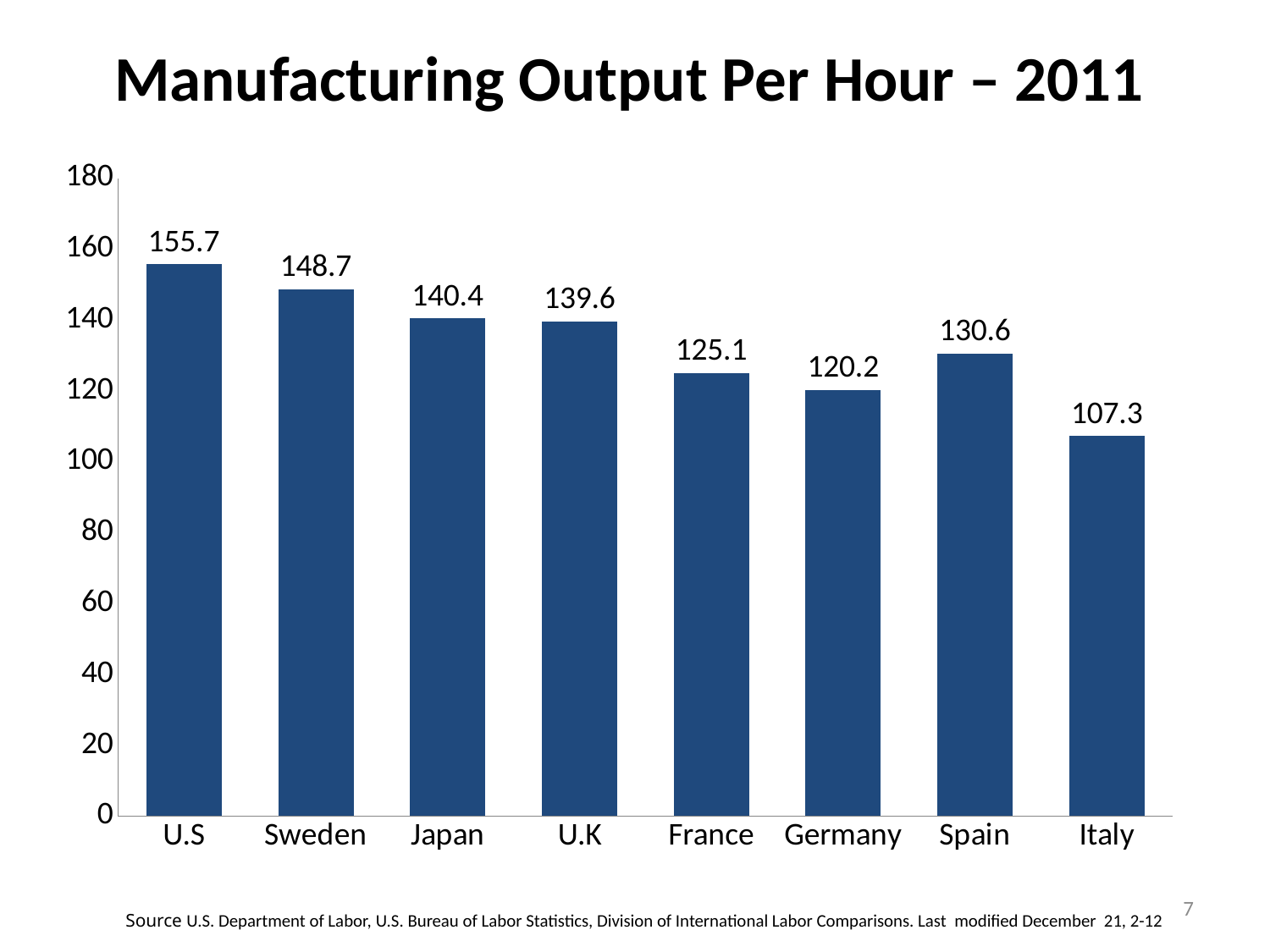
What is the title of the chart? Manufacturing Output Per Hour – 2011 Which country has the highest manufacturing output per hour? U.S What is the difference between the values for Spain and France? 5.5 How many countries are shown in the chart? 8 What is the difference between the values for the U.S and Italy? 48.4 What is the value shown for the U.K? 139.6 What is the value shown for Germany? 120.2 What kind of chart is shown on the slide? Bar chart Which has a larger value, Spain or Germany? Spain Is the value for Japan greater or less than 120? greater What is the manufacturing output per hour value for Sweden? 148.7 Which country has the lowest manufacturing output per hour? Italy